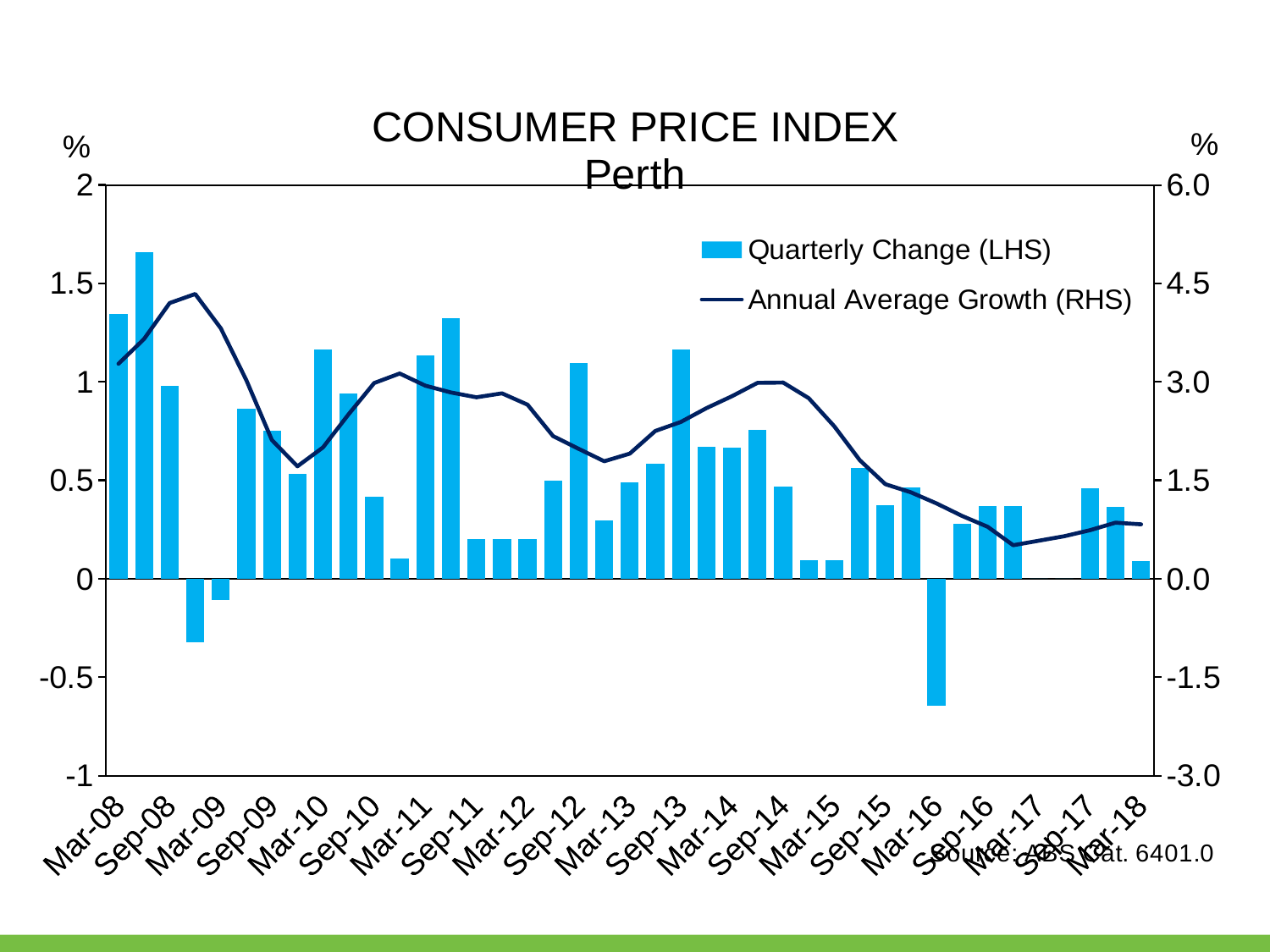
Which quarter has the lowest Quarterly Change bar? Mar-16 How many series does the legend list? 2 What is the title of the chart? CONSUMER PRICE INDEX Perth Is the Quarterly Change bar for Sep-08 greater or less than 1.5? less Which has the larger Quarterly Change bar, Mar-08 or Sep-08? Mar-08 Is the Quarterly Change bar for Mar-16 greater or less than -0.5? less Which series is plotted as a line? Annual Average Growth (RHS) Is the Annual Average Growth value at Mar-09 greater or less than 3.0? greater Does the Annual Average Growth line rise or fall between Sep-14 and Mar-17? Fall What kind of chart is shown on the slide? A combined bar and line chart